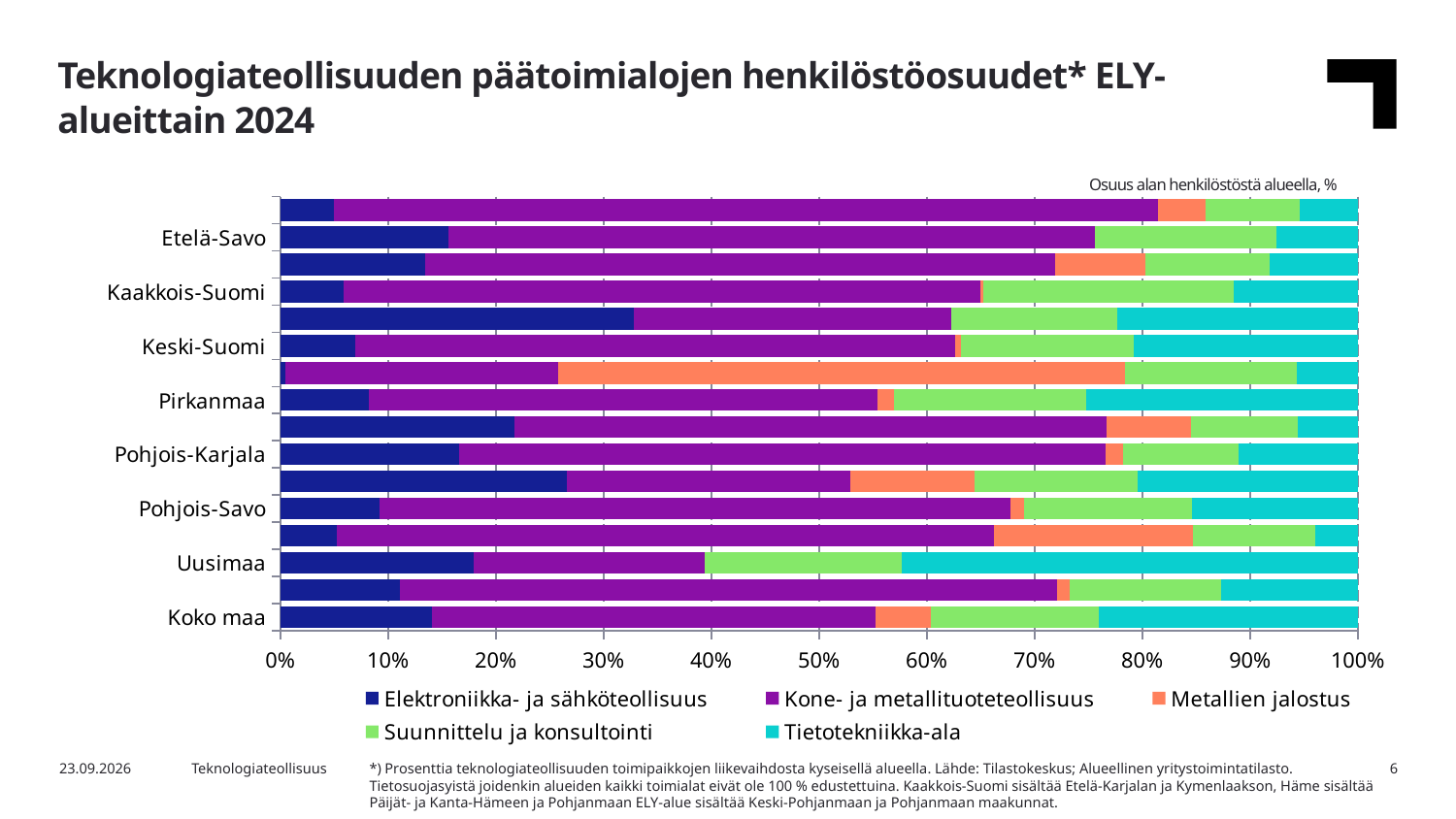
What is the title of the chart on the slide? Teknologiateollisuuden päätoimialojen henkilöstöosuudet* ELY-alueittain 2024 Is the Elektroniikka- ja sähköteollisuus share for Koko maa greater or less than 10%? greater How many region labels are printed on the vertical axis of the chart? 8 Is the Elektroniikka- ja sähköteollisuus share for Keski-Suomi greater or less than 10%? less Which has the larger Tietotekniikka-ala share, Uusimaa or Koko maa? Uusimaa Which series is shown in purple in the legend? Kone- ja metallituoteteollisuus Is the Elektroniikka- ja sähköteollisuus share for Pirkanmaa greater or less than 10%? less Which has the larger Elektroniikka- ja sähköteollisuus share, Uusimaa or Pirkanmaa? Uusimaa How many series does the legend list? 5 What kind of chart is shown on the slide? Stacked bar chart